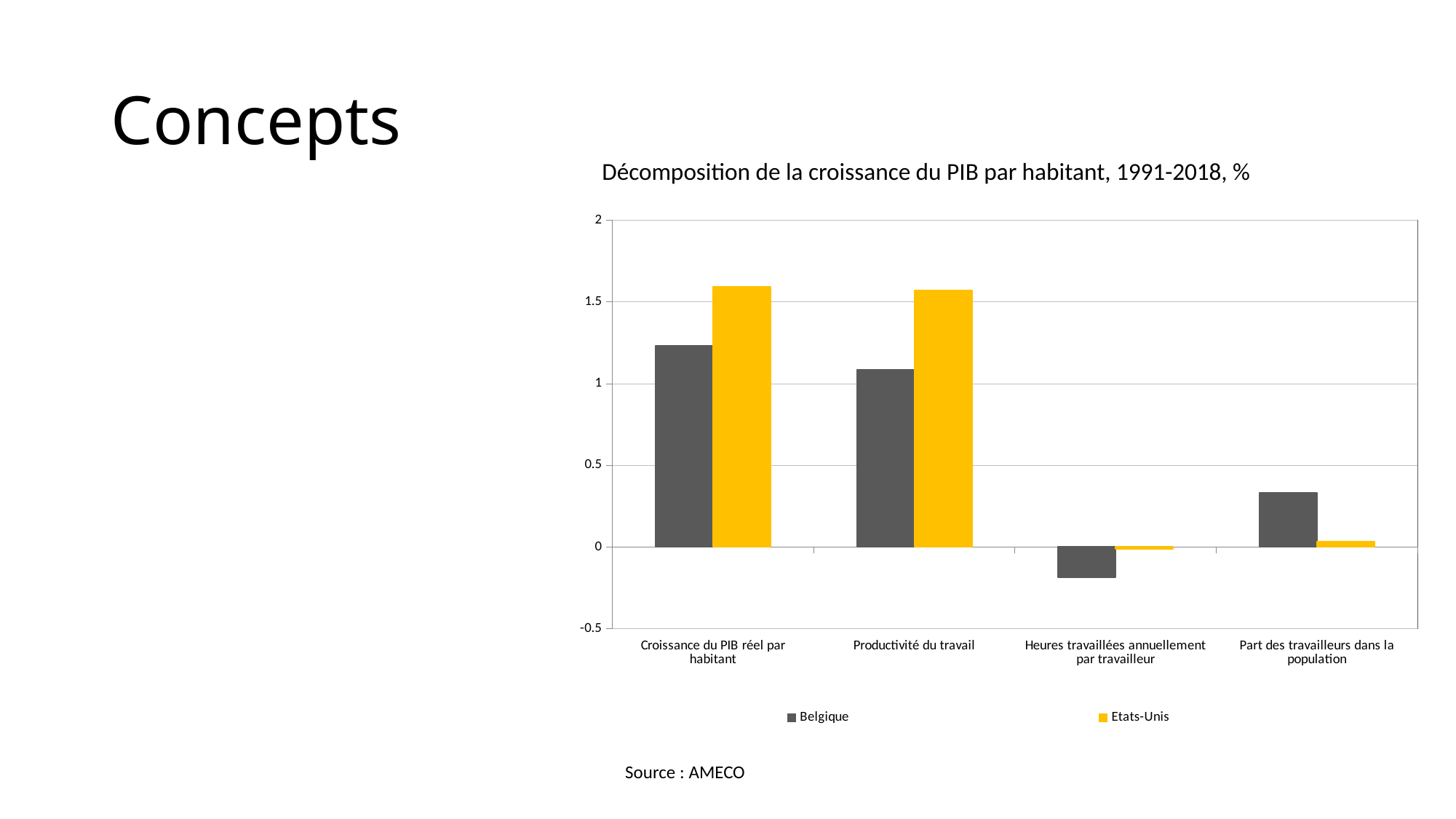
How many categories are shown on the x axis? 4 What kind of chart is shown on the slide? bar chart Is the value for Belgique in Part des travailleurs dans la population greater or less than 0.5? less Which colour represents Etats-Unis in the chart? yellow Is the value for Belgique in Heures travaillées annuellement par travailleur greater or less than 0? less Which category has the lowest value for Belgique? Heures travaillées annuellement par travailleur Which category has the highest value for Belgique? Croissance du PIB réel par habitant Is the value for Belgique in Croissance du PIB réel par habitant greater or less than 1? greater For Part des travailleurs dans la population, which series has the larger value, Belgique or Etats-Unis? Belgique How many series does the legend list? 2 For Croissance du PIB réel par habitant, which series has the larger value, Belgique or Etats-Unis? Etats-Unis What is the title of the chart? Décomposition de la croissance du PIB par habitant, 1991-2018, %